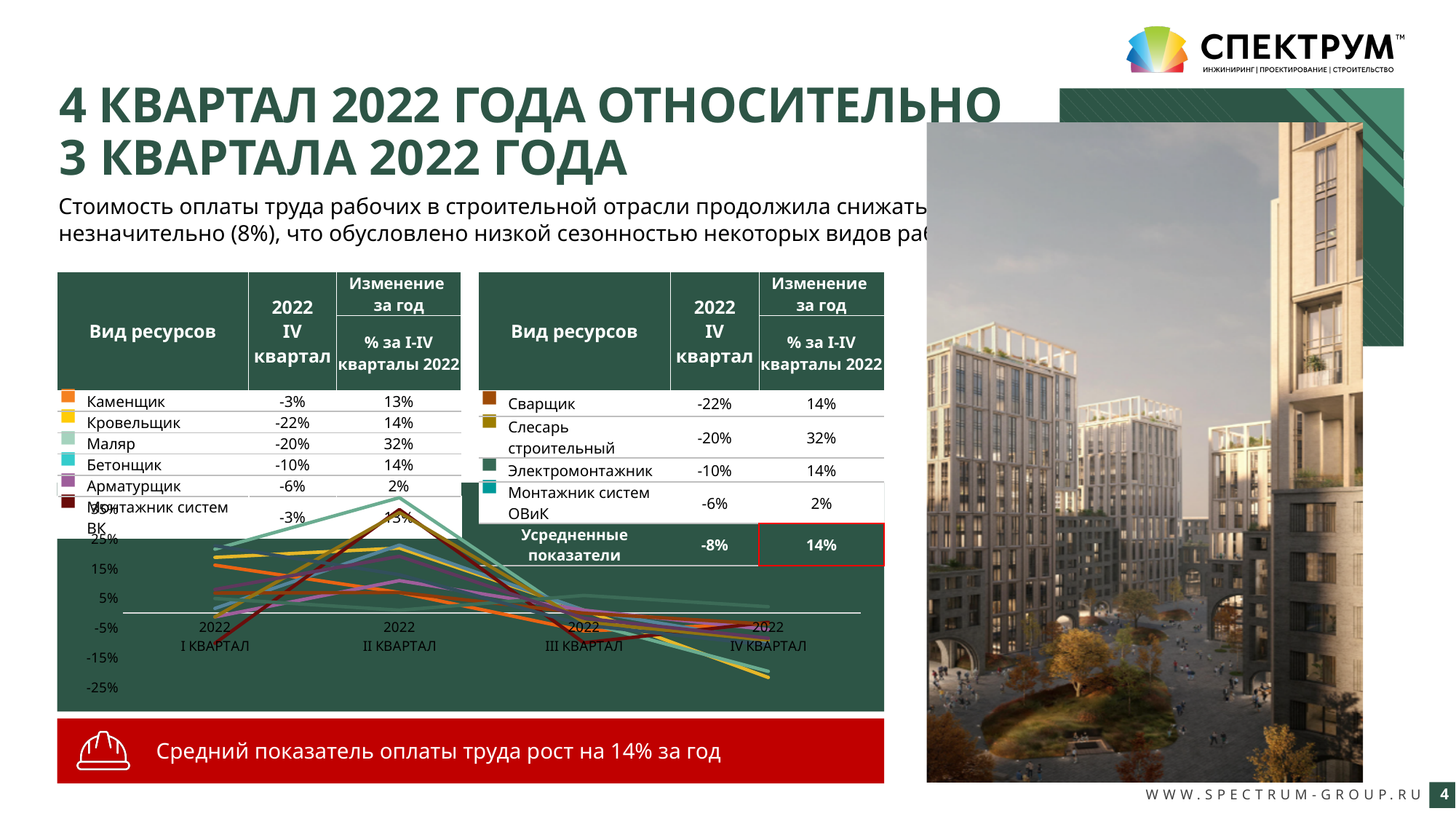
Do the lines on the chart rise or fall from 2022 II квартал to 2022 IV квартал? fall Is the highest value plotted at 2022 II квартал greater or less than 25%? greater Is the highest value plotted at 2022 IV квартал greater or less than 15%? less How many quarters are plotted along the x axis of the line chart? 4 In which quarter do the lines on the chart reach their highest values? 2022 II квартал What is the lowest tick value shown on the y axis of the line chart? -25% Is the lowest value plotted at 2022 IV квартал greater or less than -15%? less What is the highest tick value shown on the y axis of the line chart? 35% What kind of chart is shown on the slide? line chart